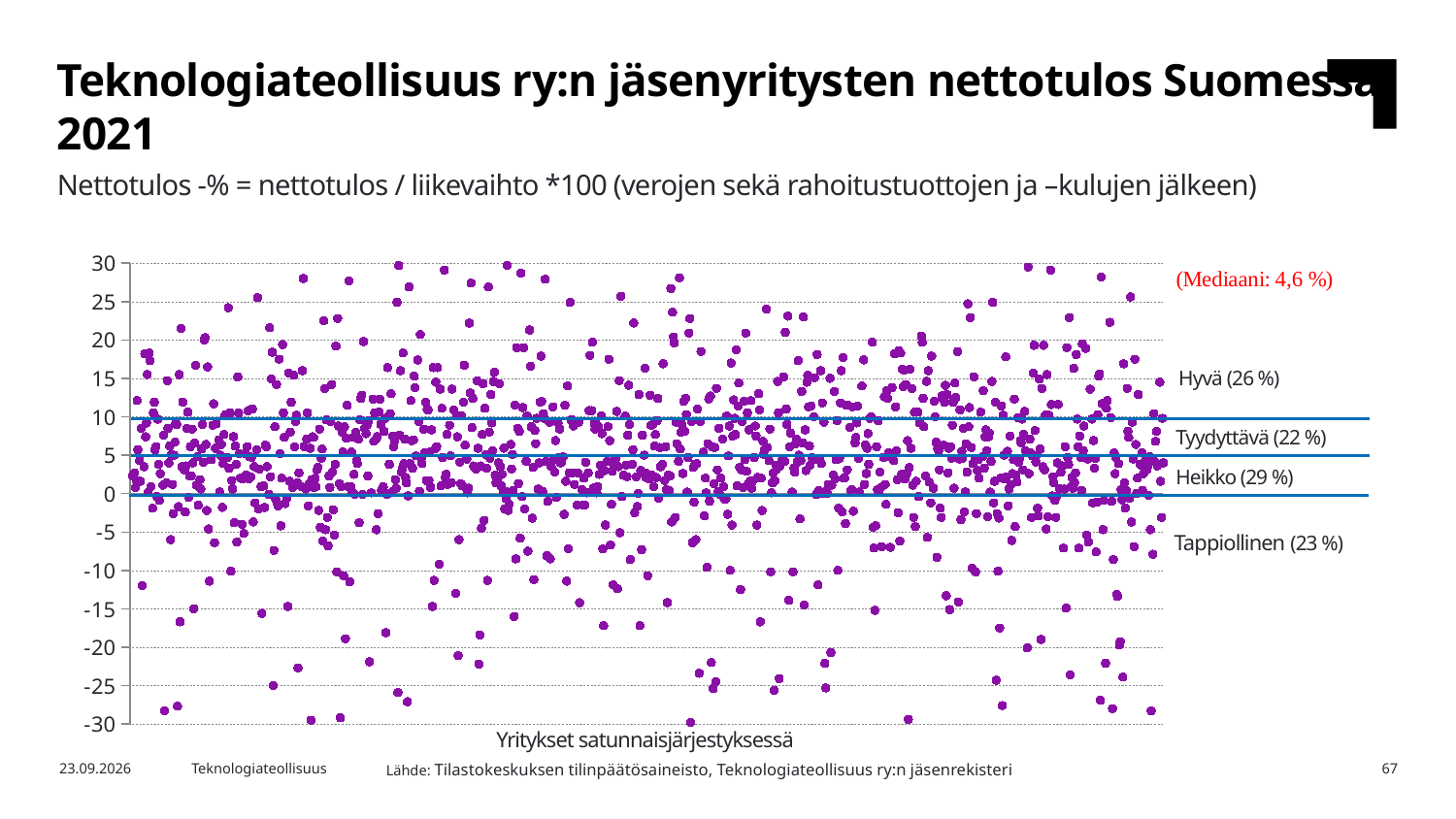
Which of the four categories (Hyvä, Tyydyttävä, Heikko, Tappiollinen) has the largest share of companies? Heikko What is the difference in percentage points between the share of 'Heikko' companies and the share of 'Tyydyttävä' companies? 7 What is the label of the x axis of the chart? Yritykset satunnaisjärjestyksessä What is the median net profit percentage stated on the chart? 4,6 % What share of companies falls into the 'Hyvä' category? 26 % What share of companies falls into the 'Tyydyttävä' category? 22 % What share of companies falls into the 'Heikko' category? 29 % What kind of chart is shown on the slide? Scatter chart Which category has a larger share of companies, 'Hyvä' or 'Tappiollinen'? Hyvä Which of the four categories (Hyvä, Tyydyttävä, Heikko, Tappiollinen) has the smallest share of companies? Tyydyttävä At which y-axis values are the three horizontal blue lines drawn on the chart? 10, 5 and 0 What share of companies falls into the 'Tappiollinen' category? 23 %